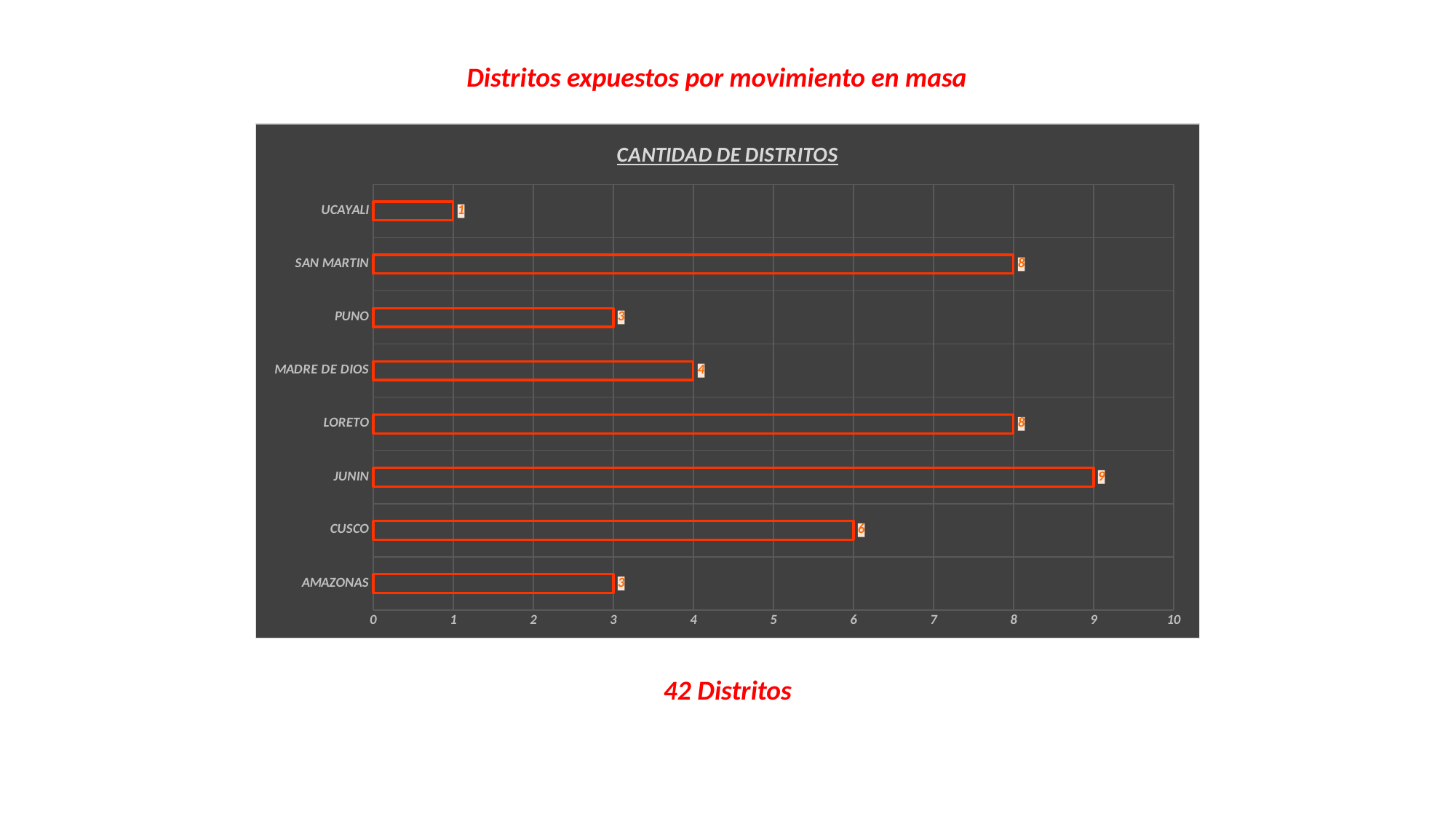
How many categories are shown in the chart? 8 What is the difference between the values for SAN MARTIN and AMAZONAS? 5 Which is larger, the value for CUSCO or the value for PUNO? CUSCO What is the difference between the values for JUNIN and CUSCO? 3 What is the value for MADRE DE DIOS? 4 What is the value for UCAYALI? 1 Which category has the highest value? JUNIN What is the title of the chart? CANTIDAD DE DISTRITOS What is the value for JUNIN? 9 Is the value for LORETO greater or less than 5? greater What kind of chart is shown? Bar chart Which category has the lowest value? UCAYALI